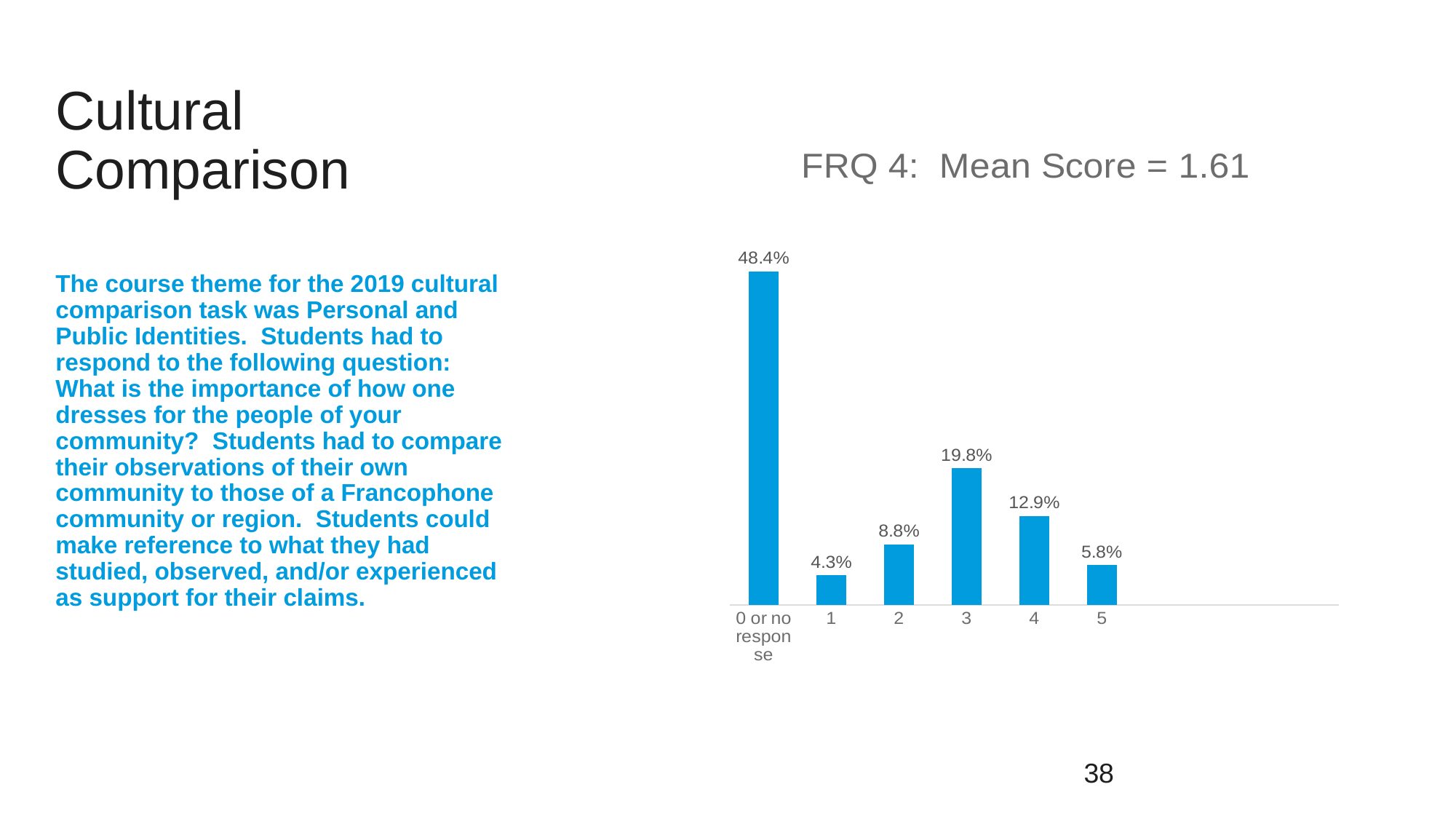
What percentage is shown for a score of 5? 5.8% How many categories are shown on the x axis of the chart? 6 Which score category has the lowest percentage? 1 What percentage of students scored 3 on FRQ 4? 19.8% Which category has the highest percentage? 0 or no response Which is larger, the percentage for score 4 or the percentage for score 2? 4 What kind of chart is shown on the slide? Bar chart What is the difference between the percentages for score 2 and score 1? 4.5% What is the difference between the percentages for score 3 and score 4? 6.9% What colour are the bars in the chart? Blue What is the title of the chart? FRQ 4: Mean Score = 1.61 What is the value shown for the '0 or no response' category? 48.4%